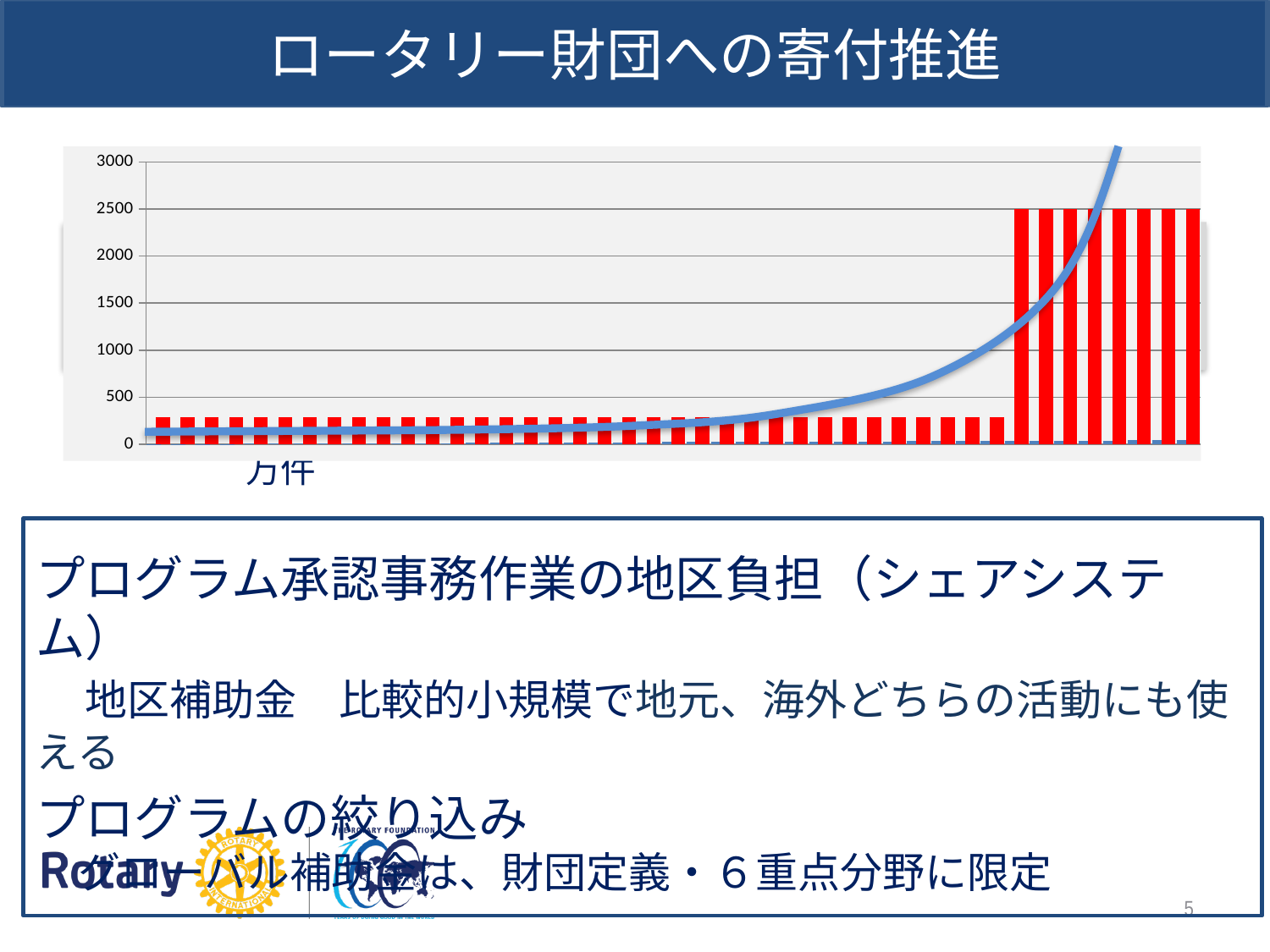
Does the blue line rise or fall from left to right across the chart? Rises What kind of chart is shown on the slide? A bar chart combined with a line What colour are the bars in the chart? Red Which are larger, the red bars on the right side of the chart or the red bars on the left side? The bars on the right side Is the value of the blue line at the far right of the chart greater or less than 2500? greater Are the tall red bars on the right side of the chart greater or less than 2000? greater Is the value of the blue line at the far left of the chart greater or less than 500? less What is the highest value shown on the vertical axis of the chart? 3000 What value on the vertical axis do the tallest red bars reach? 2500